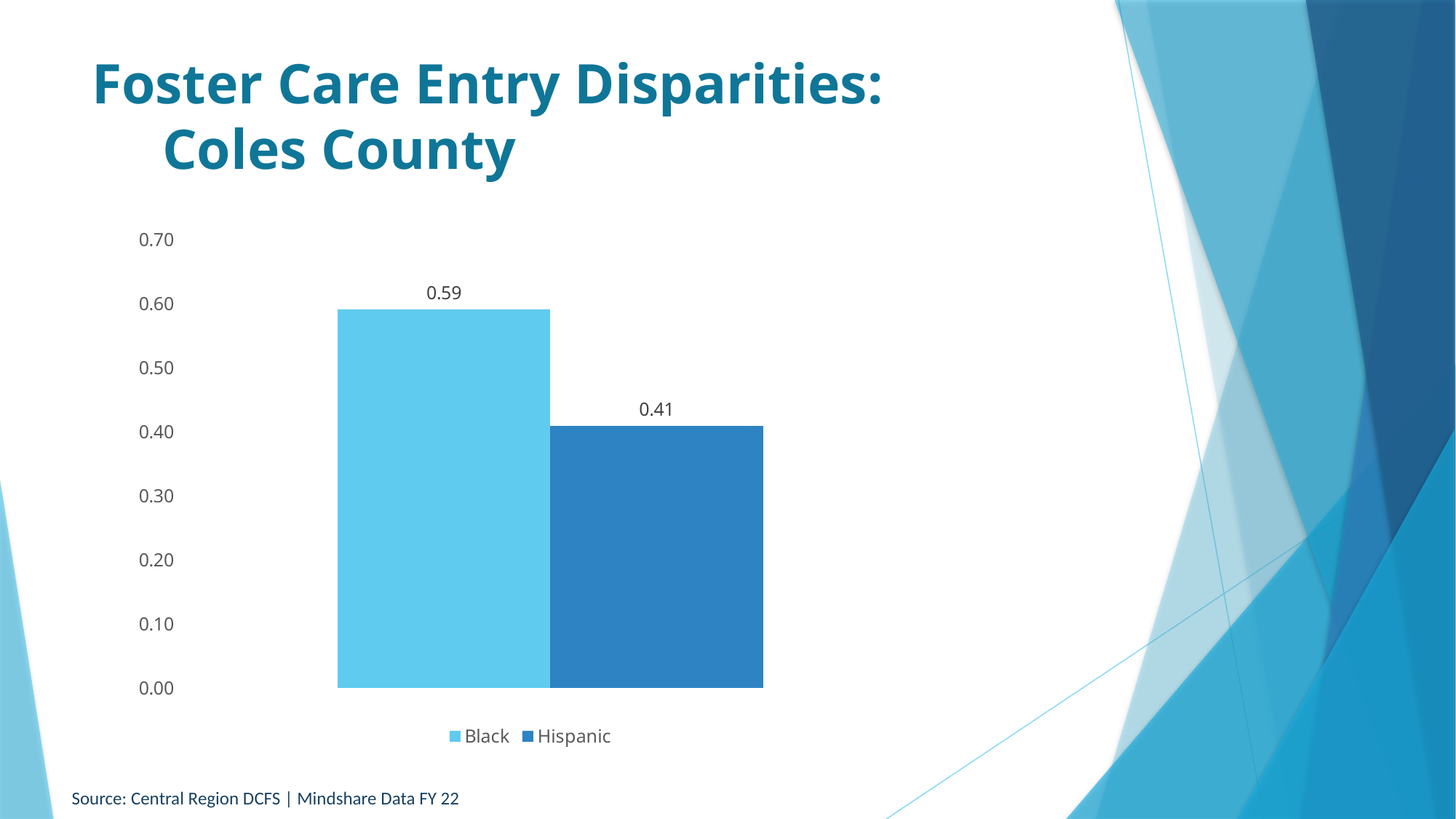
Which is larger, the value for Black or the value for Hispanic? Black What is the value for Hispanic? 0.41 What kind of chart is shown on the slide? bar chart How many bars are plotted on the chart? 2 Which series has the lowest value? Hispanic What is the difference between the values for Black and Hispanic? 0.18 What is the title of the slide containing the chart? Foster Care Entry Disparities: Coles County Is the value for Hispanic greater or less than 0.50? less What is the value for Black? 0.59 How many series does the legend list? 2 Is the value for Black greater or less than 0.50? greater Which series has the highest value? Black